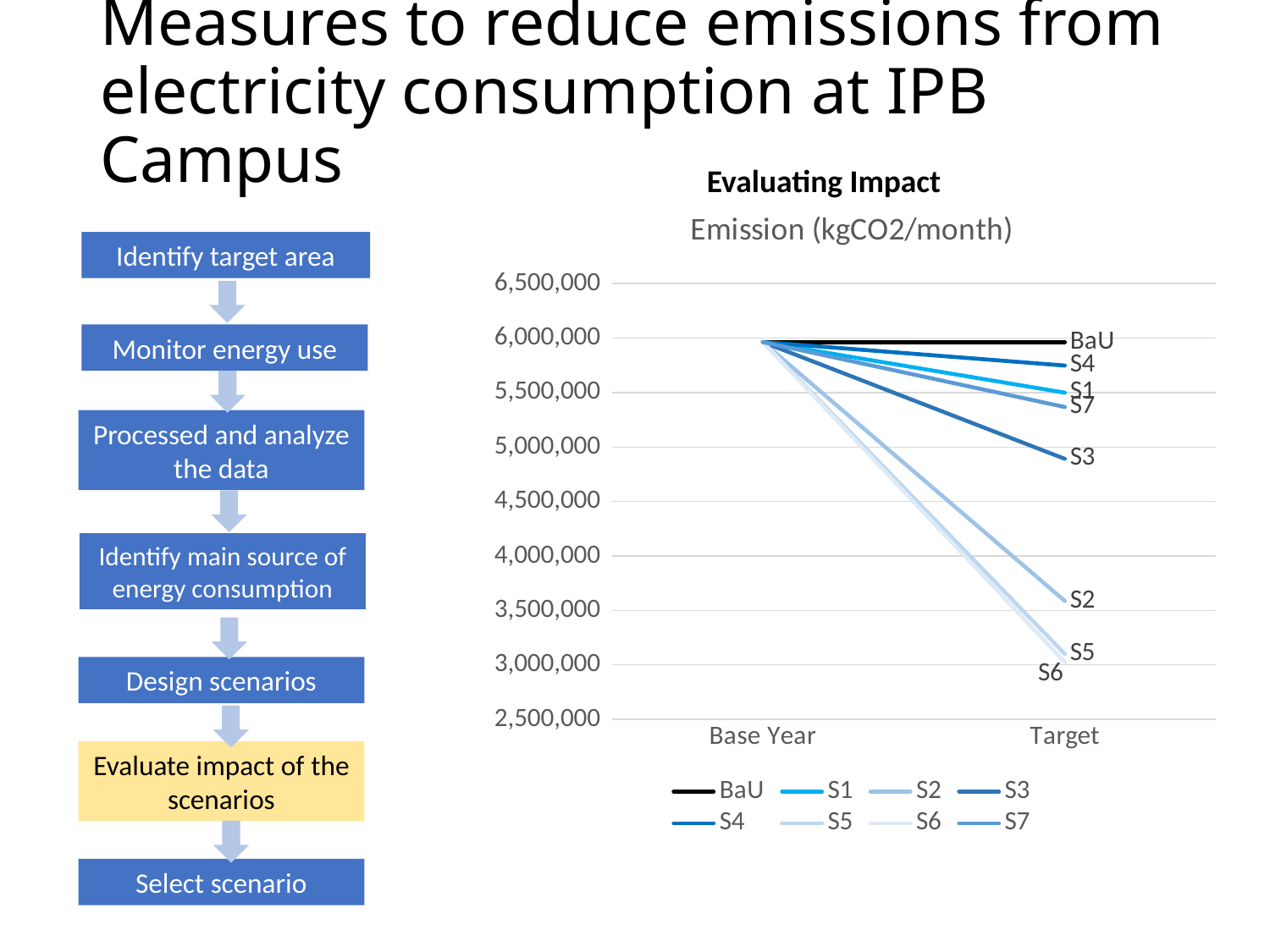
Is the value for S4 at Target greater or less than 5,500,000? greater At Target, which is larger, S2 or S3? S3 What are the two categories on the x axis of the chart? Base Year and Target How many series does the chart legend list? 8 How many categories are on the x axis of the chart? 2 What kind of chart is shown on the slide? line chart Is the value for S2 at Target greater or less than 3,500,000? greater What is the title of the chart? Emission (kgCO2/month) Is the value for S3 at Target greater or less than 5,000,000? less Does the S3 line rise or fall from Base Year to Target? fall Which series has the highest value at Target? BaU